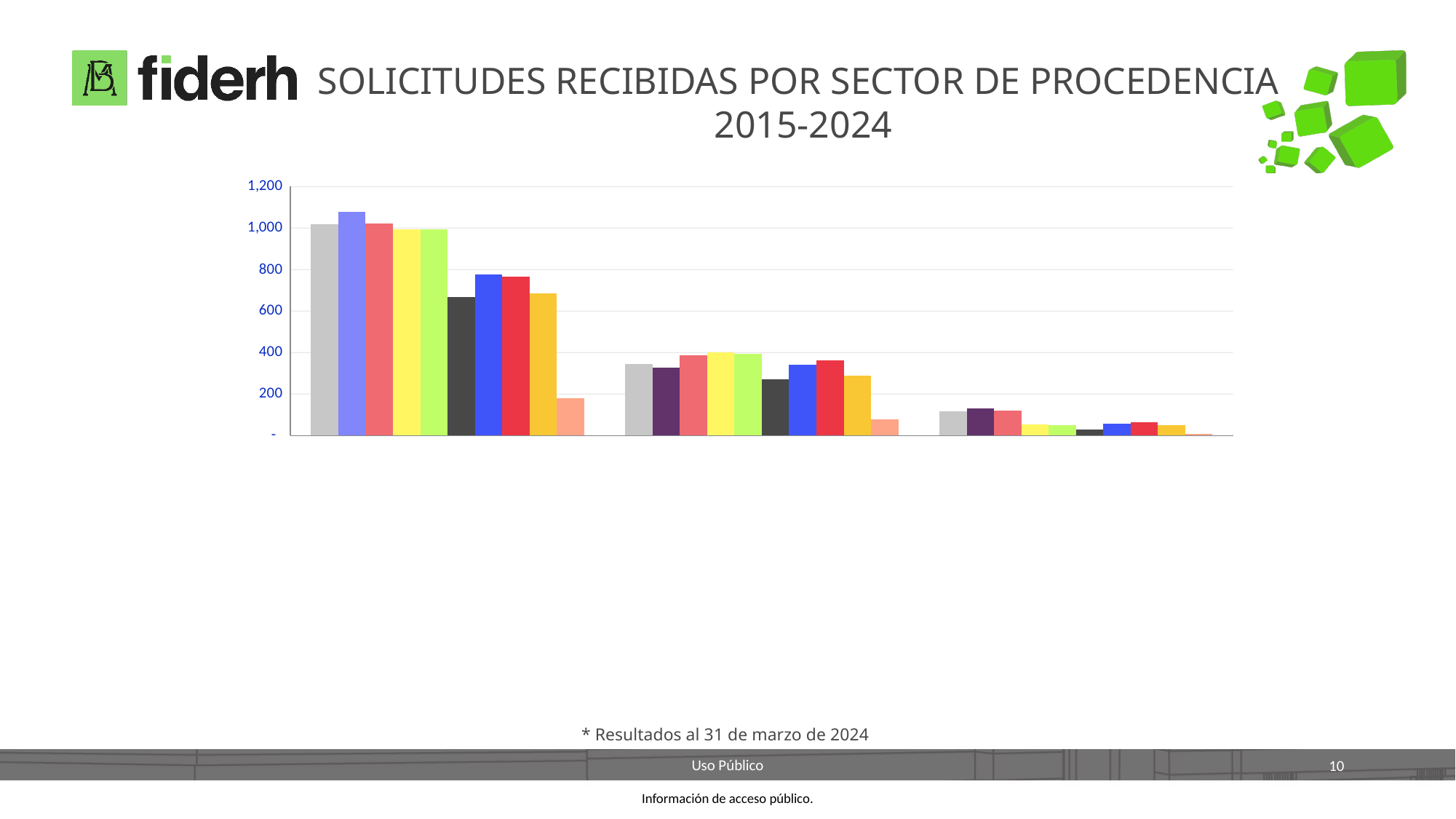
What is the title of the chart on the slide? SOLICITUDES RECIBIDAS POR SECTOR DE PROCEDENCIA 2015-2024 Do the bar heights of the groups rise or fall from left to right across the chart? fall What kind of chart is shown on the slide? bar chart How many groups of bars does the chart contain? 3 Is the dark grey (fifth) bar in the leftmost group greater or less than 600? greater How many bars are in each group of the chart? 10 Is the tallest bar in the rightmost group greater or less than 200? less Is the tallest bar in the leftmost group greater or less than 1,000? greater Which group of bars has the tallest bars: the leftmost, middle or rightmost? leftmost Is the tallest bar in the middle group greater or less than the shortest bar in the leftmost group? greater What is the highest value shown on the vertical axis of the chart? 1,200